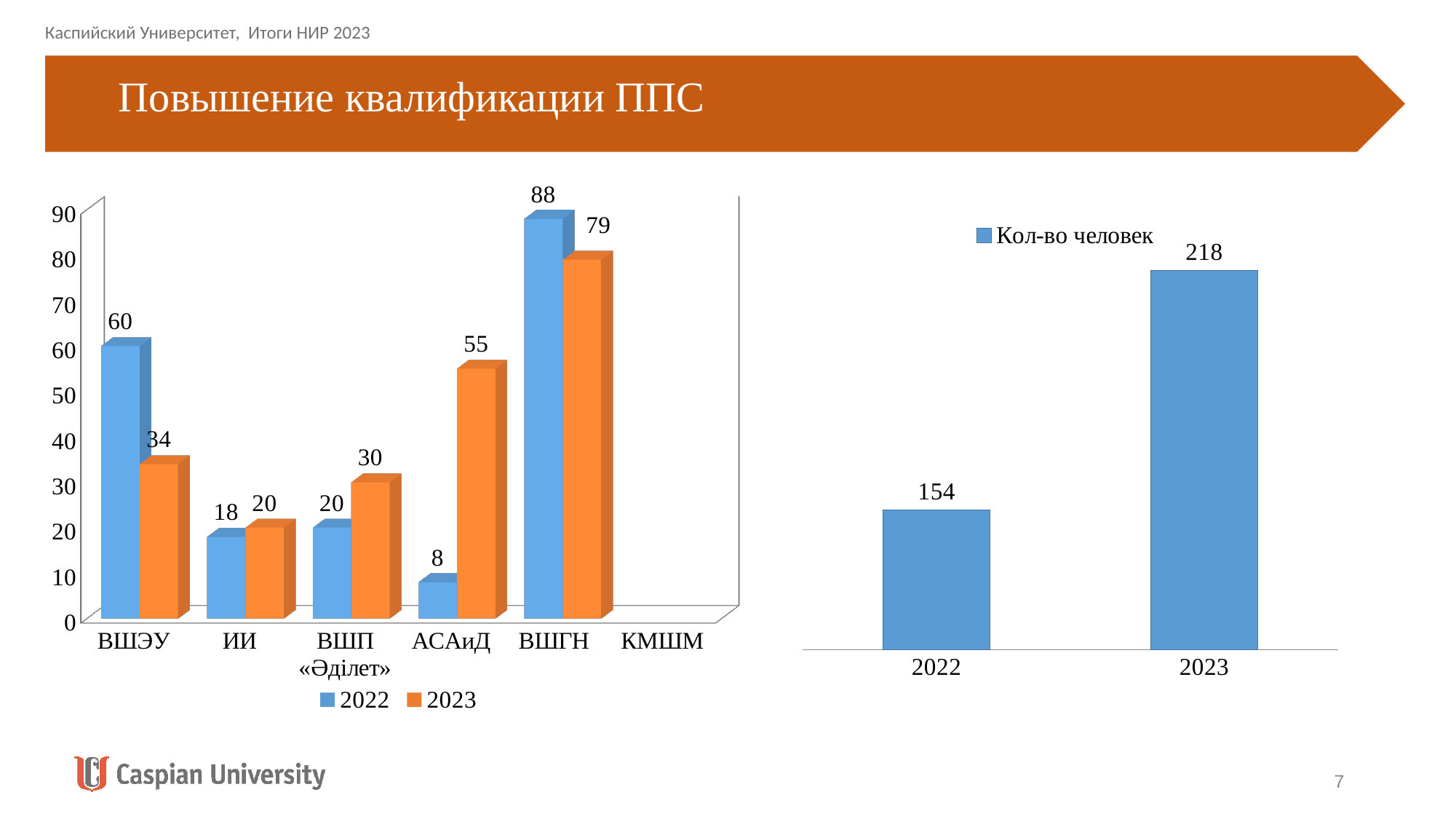
In the left chart, which is larger for ИИ: the 2022 value or the 2023 value? 2023 In the left chart, what is the 2023 value for АСАиД? 55 What kind of chart is the left chart? Bar chart In the left chart, which category has the highest 2022 value? ВШГН In the left chart, what is the difference between the 2022 and 2023 values for ВШГН? 9 In the left chart, what is the 2023 value for ВШП «Әділет»? 30 In the right chart, what is the difference between the 2023 and 2022 values? 64 How many series does the legend of the left chart list? 2 In the right chart, what is the value for 2023? 218 What is the legend entry of the right chart? Кол-во человек In the left chart, which category has the lowest 2022 value? АСАиД In the left chart, what is the 2022 value for ВШЭУ? 60